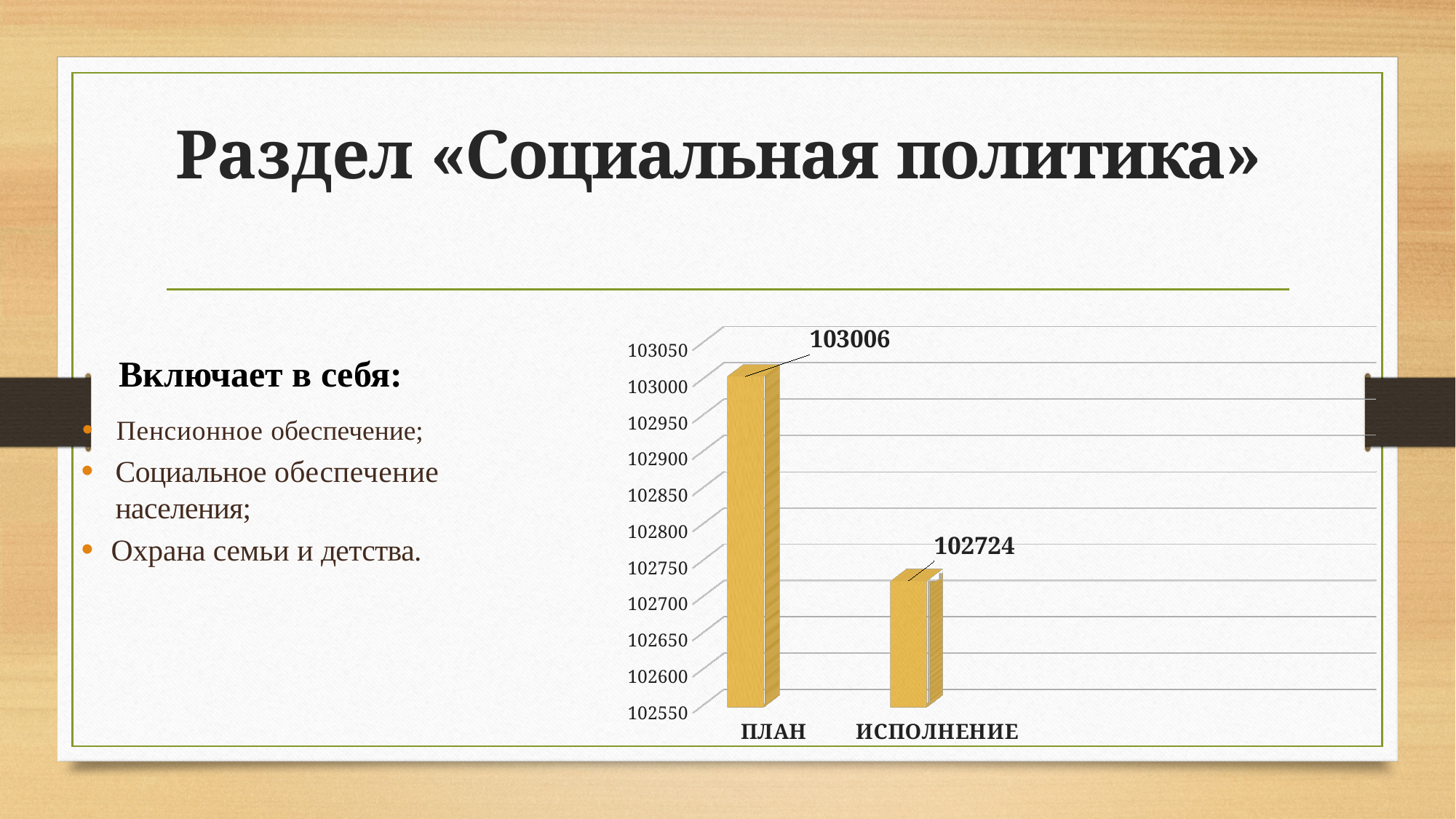
What is the value for ИСПОЛНЕНИЕ? 102724 Which category has the highest value? ПЛАН Which category has the lowest value? ИСПОЛНЕНИЕ Do the values rise or fall from ПЛАН to ИСПОЛНЕНИЕ? fall What is the difference between the values for ПЛАН and ИСПОЛНЕНИЕ? 282 Is the value for ИСПОЛНЕНИЕ greater or less than 102750? less What is the lowest value shown on the vertical axis of the chart? 102550 Which is larger, the value for ПЛАН or the value for ИСПОЛНЕНИЕ? ПЛАН Is the value for ПЛАН greater or less than 103000? greater What kind of chart is shown on the slide? bar chart How many categories are shown on the chart? 2 What is the value for ПЛАН? 103006